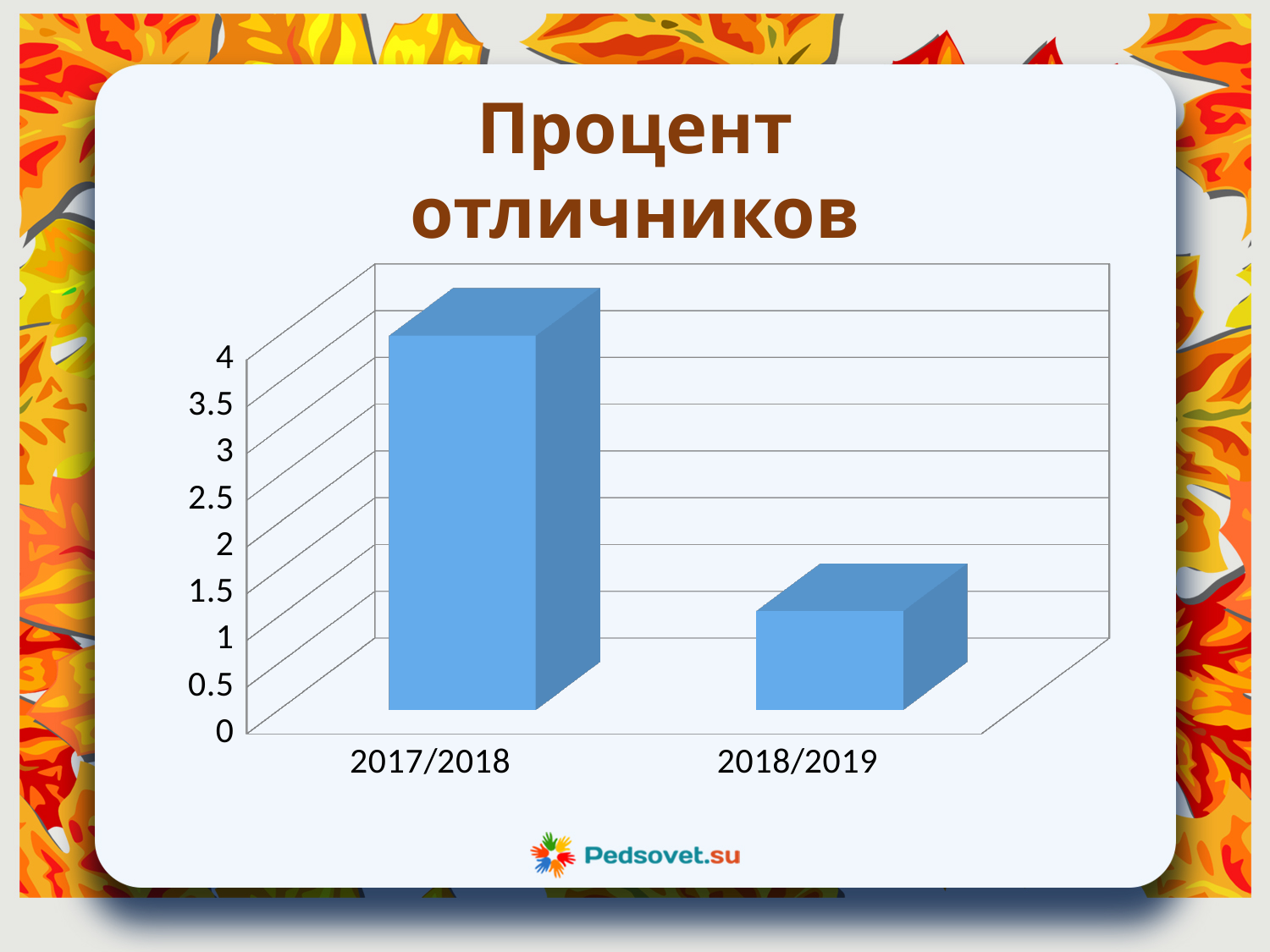
What is the title of the chart? Процент отличников What kind of chart is shown on the slide? bar chart Is the value for 2018/2019 greater or less than 2? less Do the values rise or fall from 2017/2018 to 2018/2019? fall How many categories are shown on the x axis of the chart? 2 Is the value for 2018/2019 greater or less than 0.5? greater What is the highest value shown on the vertical axis of the chart? 4 Which category has the lowest value in the chart? 2018/2019 Which category has the highest value in the chart? 2017/2018 Which is larger, the value for 2017/2018 or the value for 2018/2019? 2017/2018 Is the value for 2017/2018 greater or less than 3? greater